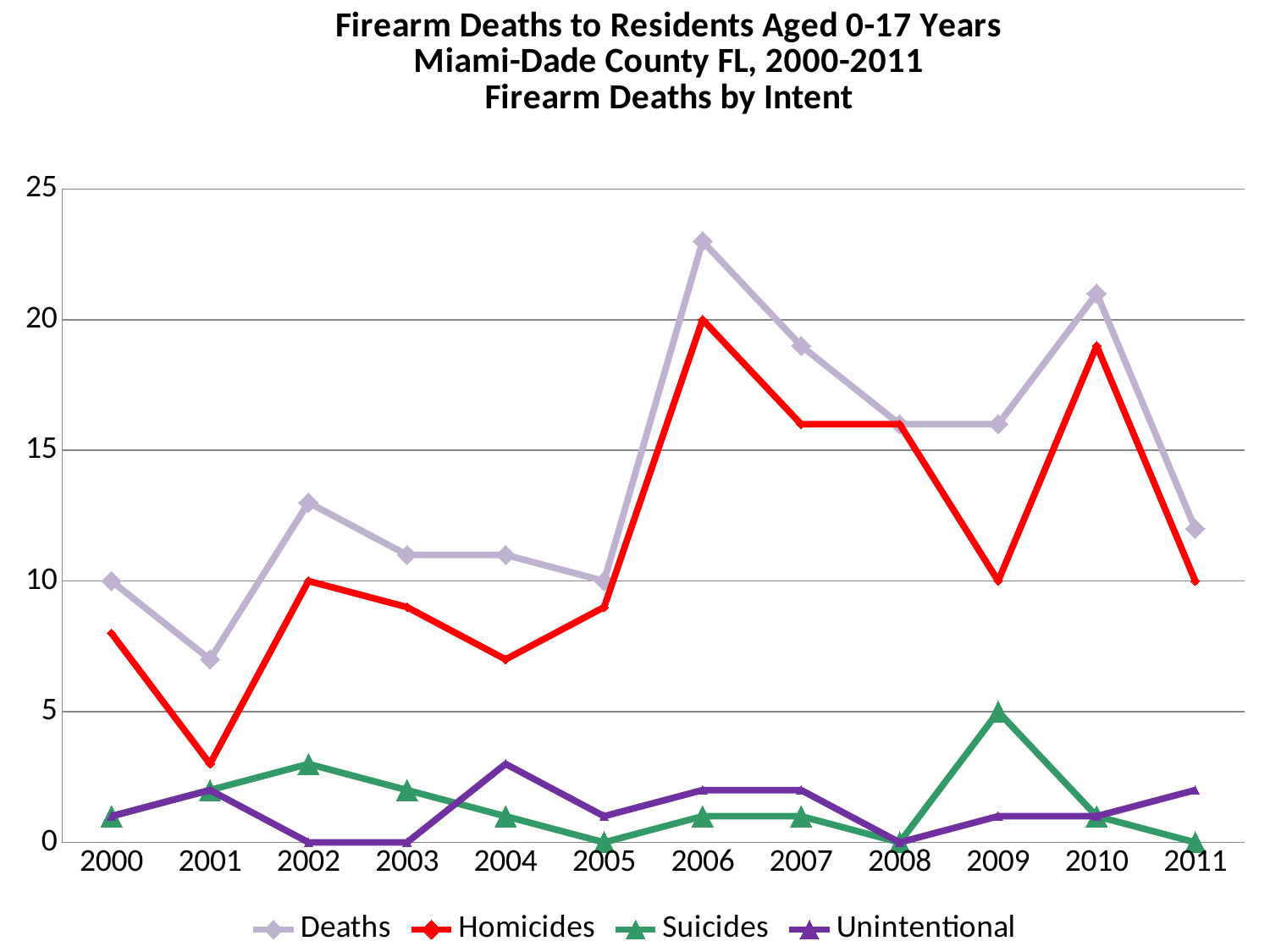
What kind of chart is shown on the slide? line chart Is the value for Deaths in 2010 greater or less than 20? greater How many series does the legend list? 4 What is the value for Suicides in 2009? 5 What is the value for Deaths in 2000? 10 How many years are plotted along the x axis? 12 What is the value for Homicides in 2006? 20 What is the value for Unintentional in 2002? 0 In which year is the Deaths series highest? 2006 In which year is the Homicides series lowest? 2001 Is the value for Homicides in 2004 greater or less than 10? less Which is larger in 2009, Suicides or Unintentional? Suicides